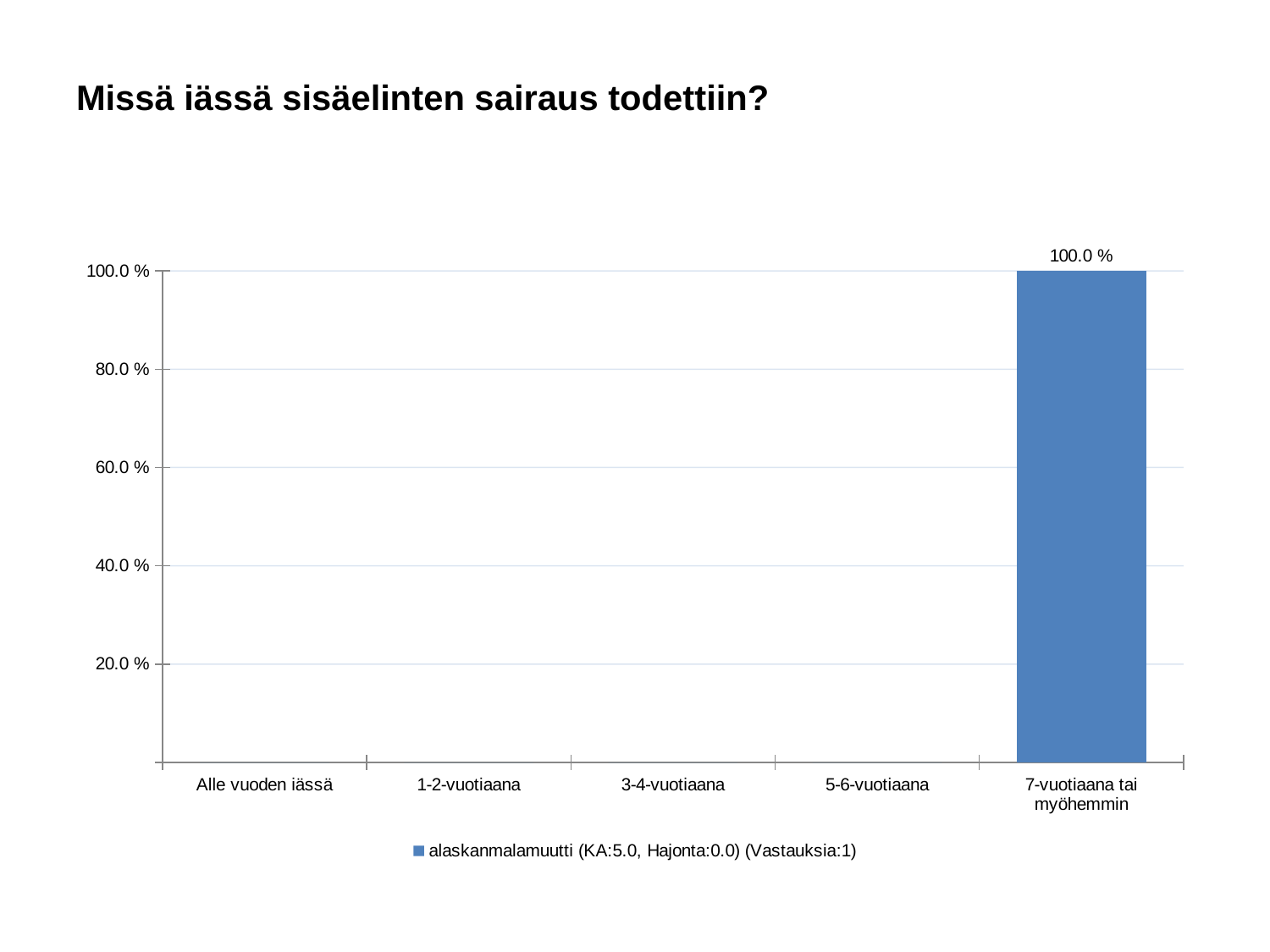
Is the value for "7-vuotiaana tai myöhemmin" greater or less than 80.0 %? greater What is the value for "7-vuotiaana tai myöhemmin"? 100.0 % What is the highest tick value shown on the y axis? 100.0 % What is the legend entry for the series? alaskanmalamuutti (KA:5.0, Hajonta:0.0) (Vastauksia:1) What is the title of the slide? Missä iässä sisäelinten sairaus todettiin? Which category has the highest value? 7-vuotiaana tai myöhemmin What is the label of the first category on the x axis? Alle vuoden iässä How many categories are shown on the x axis? 5 How many series does the legend list? 1 Which is larger, the value for "7-vuotiaana tai myöhemmin" or the value for "3-4-vuotiaana"? 7-vuotiaana tai myöhemmin What kind of chart is shown on the slide? bar chart